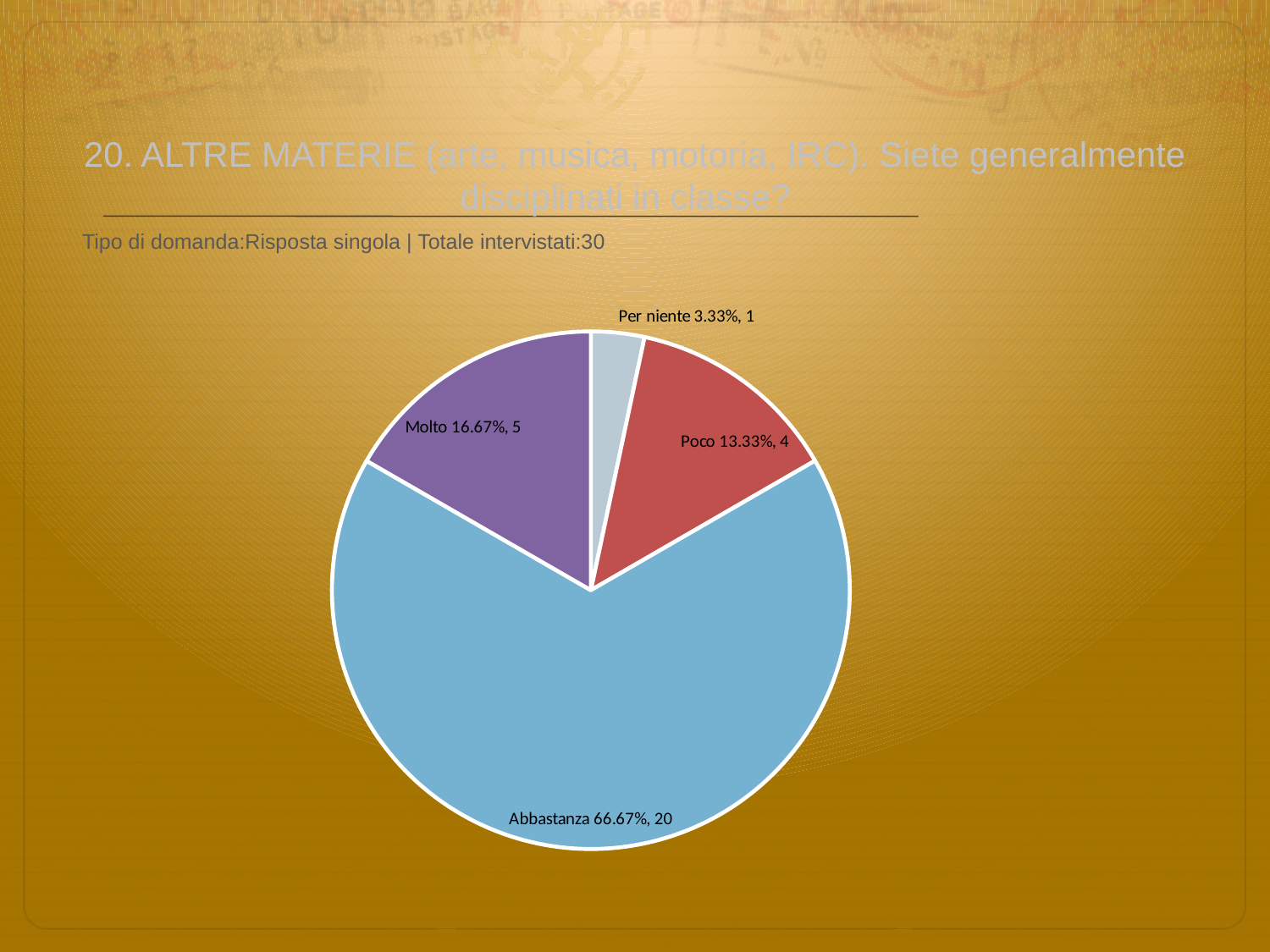
What is the difference in respondent count between Abbastanza and Molto? 15 What is the total number of respondents across all slices? 30 Which is larger, the Molto slice or the Poco slice? Molto Which category has the largest slice? Abbastanza What percentage share does the Per niente slice have? 3.33% What kind of chart is shown on the slide? pie chart What colour is the Abbastanza slice? light blue How many respondents answered Molto? 5 Which category has the smallest slice? Per niente How many slices does the pie chart have? 4 How many respondents answered Poco? 4 What percentage share does the Abbastanza slice have? 66.67%